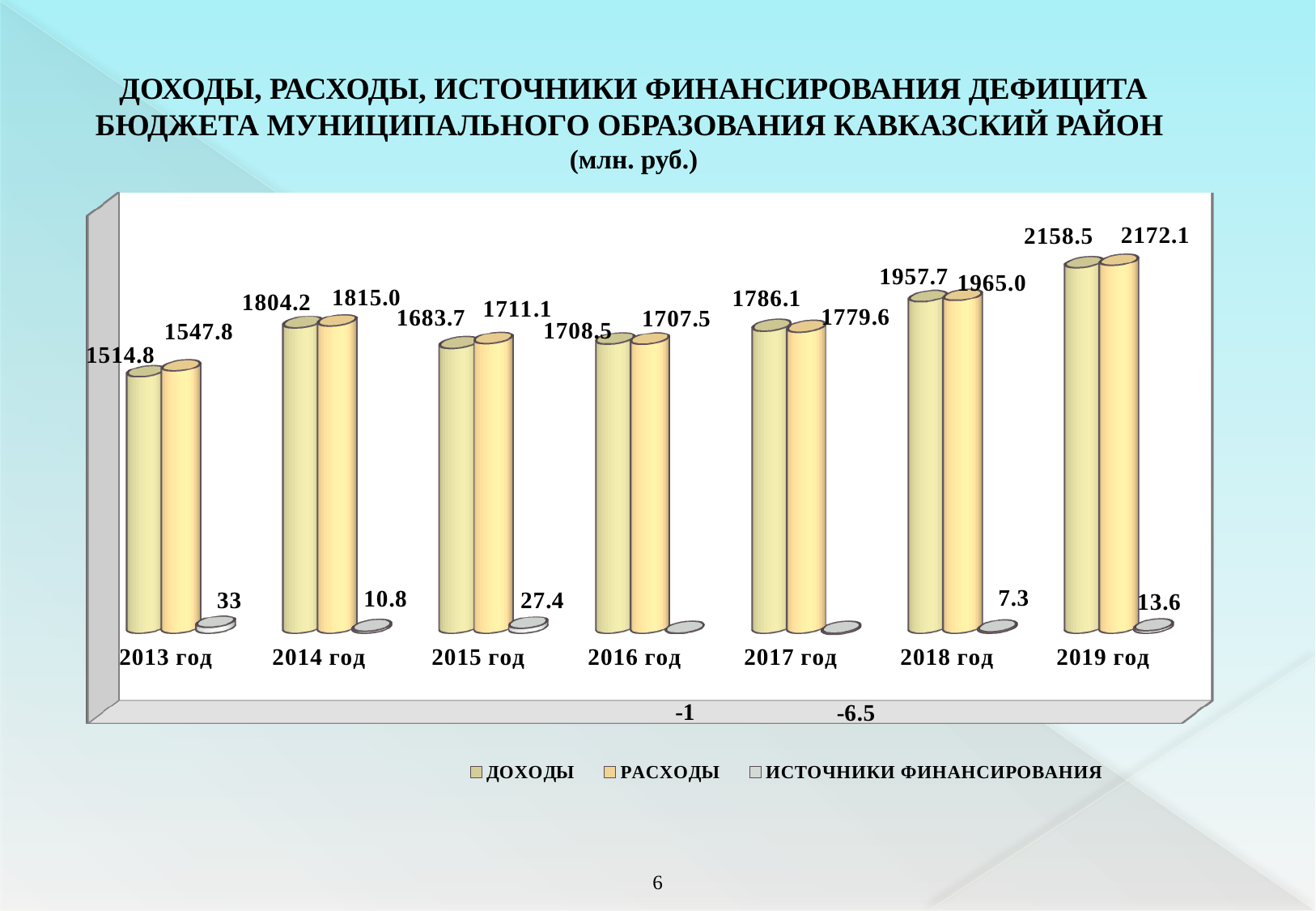
How many years are shown on the x axis? 7 What kind of chart is shown on the slide? Bar chart What is the value of ИСТОЧНИКИ ФИНАНСИРОВАНИЯ for 2017 год? -6.5 Which is larger for 2017 год: ДОХОДЫ or РАСХОДЫ? ДОХОДЫ What is the difference between ДОХОДЫ for 2018 год and ДОХОДЫ for 2017 год? 171.6 In which year is РАСХОДЫ the lowest? 2013 год What is the value of ДОХОДЫ for 2019 год? 2158.5 What is the value of РАСХОДЫ for 2015 год? 1711.1 In which year is ДОХОДЫ the highest? 2019 год How many series does the legend list? 3 What is the value of ИСТОЧНИКИ ФИНАНСИРОВАНИЯ for 2013 год? 33 What is the difference between РАСХОДЫ and ДОХОДЫ for 2019 год? 13.6